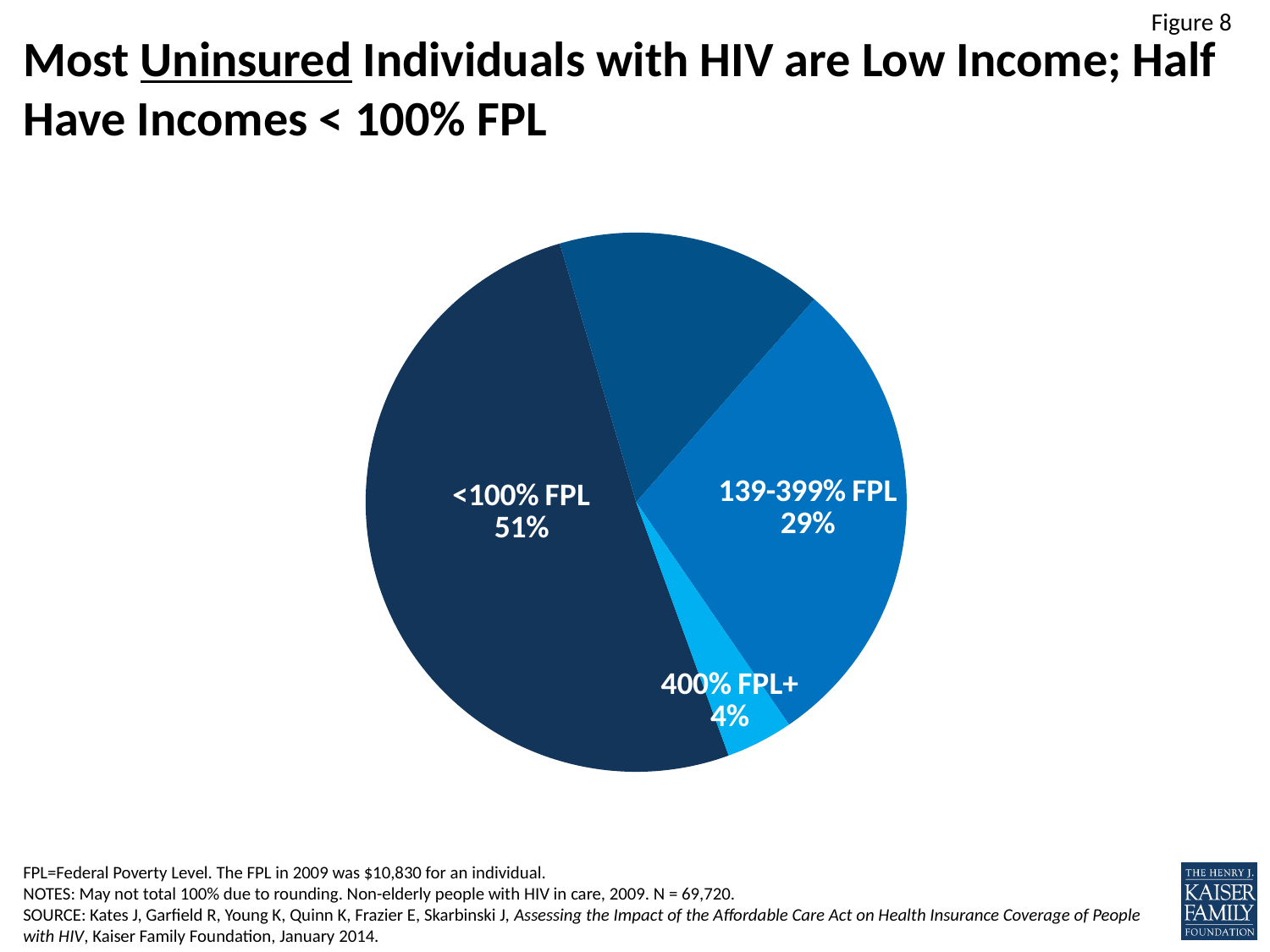
What share of uninsured individuals with HIV have incomes <100% FPL? 51% What percentage is shown for the 139-399% FPL slice? 29% What is the sample size (N) given in the notes on the slide? 69,720 What kind of chart is shown on the slide? pie chart What figure number is shown on the slide? Figure 8 Which is larger, the 139-399% FPL slice or the 400% FPL+ slice? 139-399% FPL How many slices does the pie chart have? 4 What percentage is shown for the 400% FPL+ slice? 4% Which labeled income group has the largest share of the pie? <100% FPL What is the combined share of the 139-399% FPL and 400% FPL+ slices? 33% Which labeled income group has the smallest share of the pie? 400% FPL+ What is the difference in percentage points between the <100% FPL slice and the 139-399% FPL slice? 22